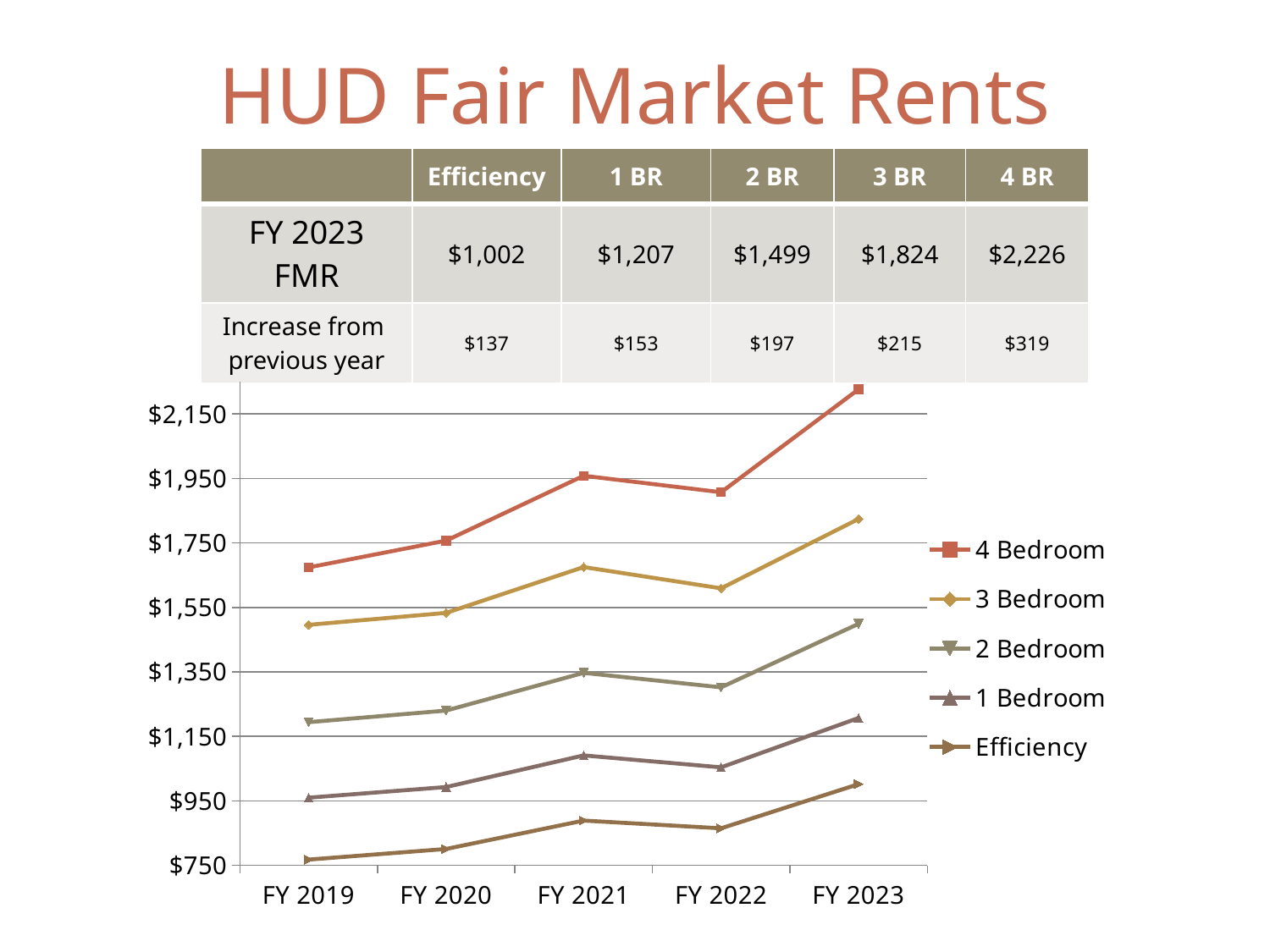
Is the 3 Bedroom value for FY 2021 greater or less than $1,550? greater Is the 4 Bedroom value for FY 2019 greater or less than $1,750? less Is the 1 Bedroom value for FY 2022 greater or less than $1,150? less Which series has the highest values across all years in the chart? 4 Bedroom In which fiscal year does the 4 Bedroom series reach its highest value? FY 2023 How many series does the chart legend list? 5 How many fiscal years are plotted along the x axis of the chart? 5 Which series has the lowest values across all years in the chart? Efficiency Does the 4 Bedroom series rise or fall from FY 2021 to FY 2022? fall Which is larger in FY 2020: the 2 Bedroom value or the 1 Bedroom value? 2 Bedroom What kind of chart is shown on the slide? line chart